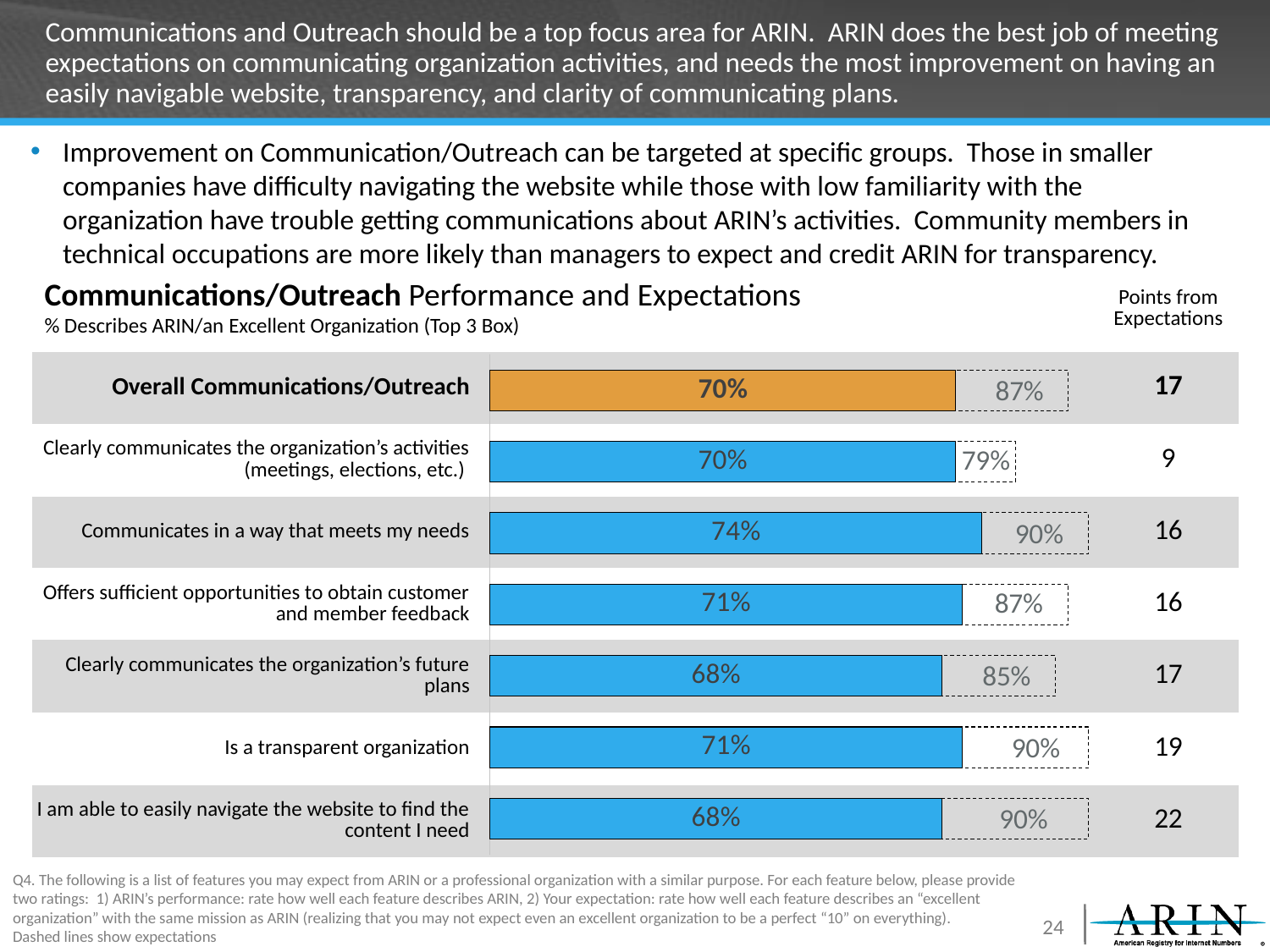
What is the performance value for "Overall Communications/Outreach"? 70% How many points from expectations is "I am able to easily navigate the website to find the content I need"? 22 What is the performance value for "Communicates in a way that meets my needs"? 74% What kind of chart is shown on the slide? Bar chart What is the expectation value for "Clearly communicates the organization's future plans"? 85% What is the difference between the expectation and performance values for "Is a transparent organization"? 19 According to the footnote, what do the dashed lines in the chart show? Expectations Which has a higher performance value: "Offers sufficient opportunities to obtain customer and member feedback" or "Clearly communicates the organization's future plans"? Offers sufficient opportunities to obtain customer and member feedback Which item has the lowest expectation value? Clearly communicates the organization's activities (meetings, elections, etc.) How many items (categories) are shown in the chart? 7 Which item has the highest performance value? Communicates in a way that meets my needs What is the expectation value (dashed bar) for "Clearly communicates the organization's activities (meetings, elections, etc.)"? 79%